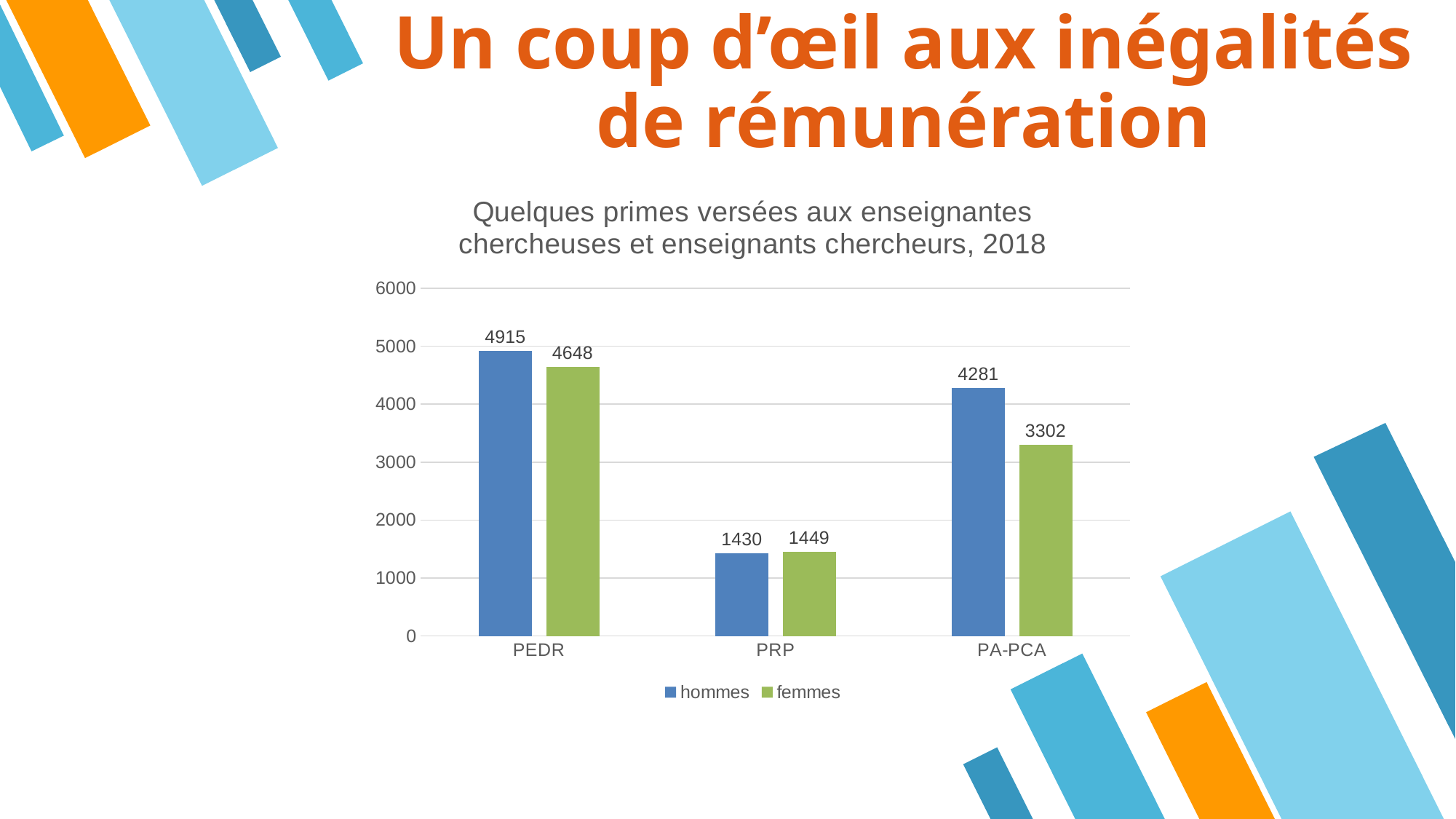
How many series does the legend list? 2 How many categories are shown on the x axis? 3 What kind of chart is shown on the slide? bar chart Which category has the highest value for hommes? PEDR Is the value for femmes in PEDR greater or less than 4000? greater What is the difference between hommes and femmes in the PEDR category? 267 What is the difference between hommes and femmes in the PA-PCA category? 979 Which is larger in the PA-PCA category, hommes or femmes? hommes What is the value for femmes in the PRP category? 1449 What is the value for hommes in the PEDR category? 4915 What is the value for femmes in the PA-PCA category? 3302 Which category has the lowest value for femmes? PRP